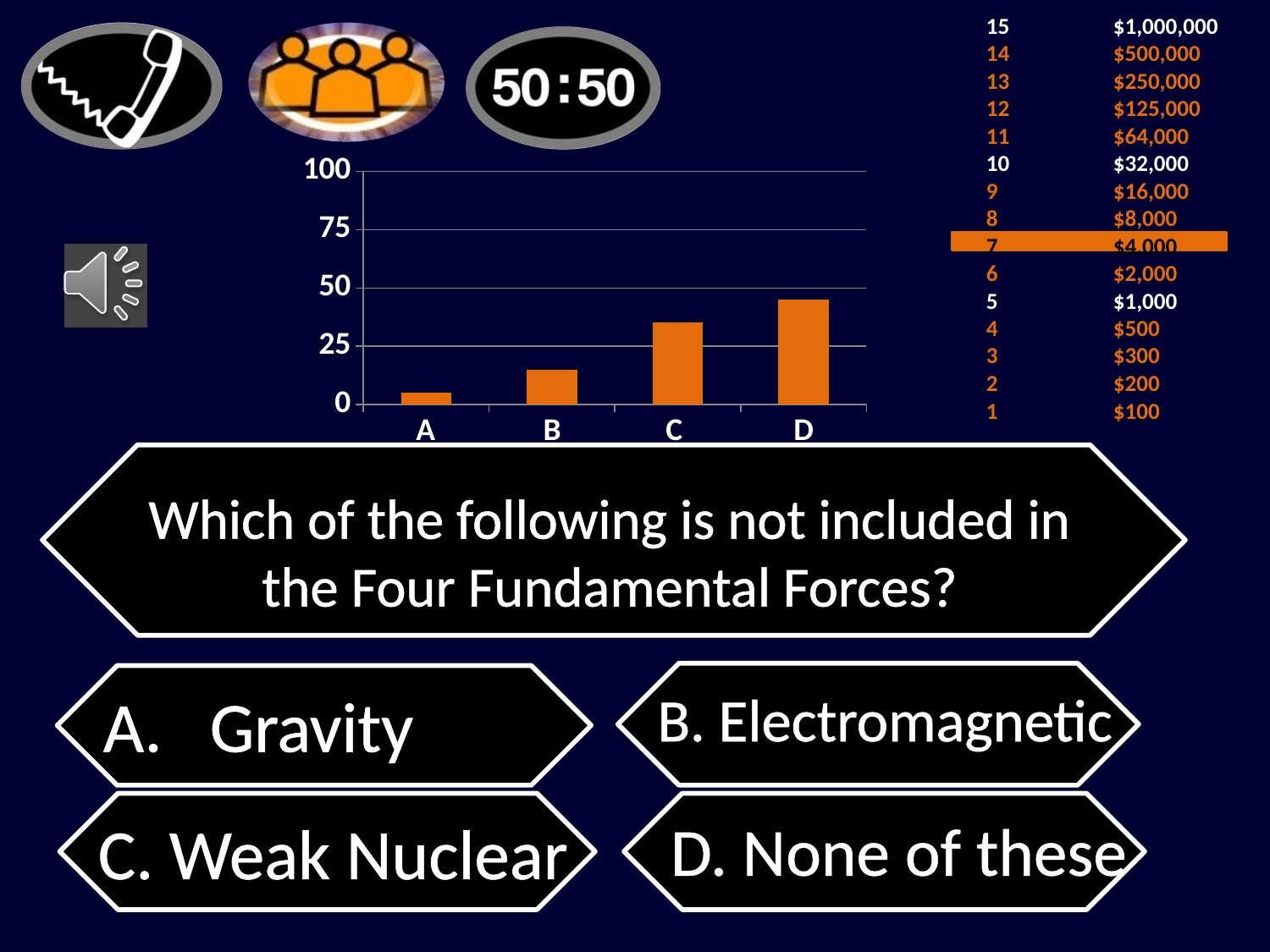
What kind of chart is shown on the slide? bar chart Is the value for B greater or less than 25? less Is the value for C greater or less than 50? less Is the value for D greater or less than 50? less Which category has the highest bar in the chart? D Which is larger, the value for B or the value for C? C How many categories are shown on the x axis of the chart? 4 Do the bar values rise or fall from A to D? rise Which category has the lowest bar in the chart? A What is the highest value shown on the chart's y axis? 100